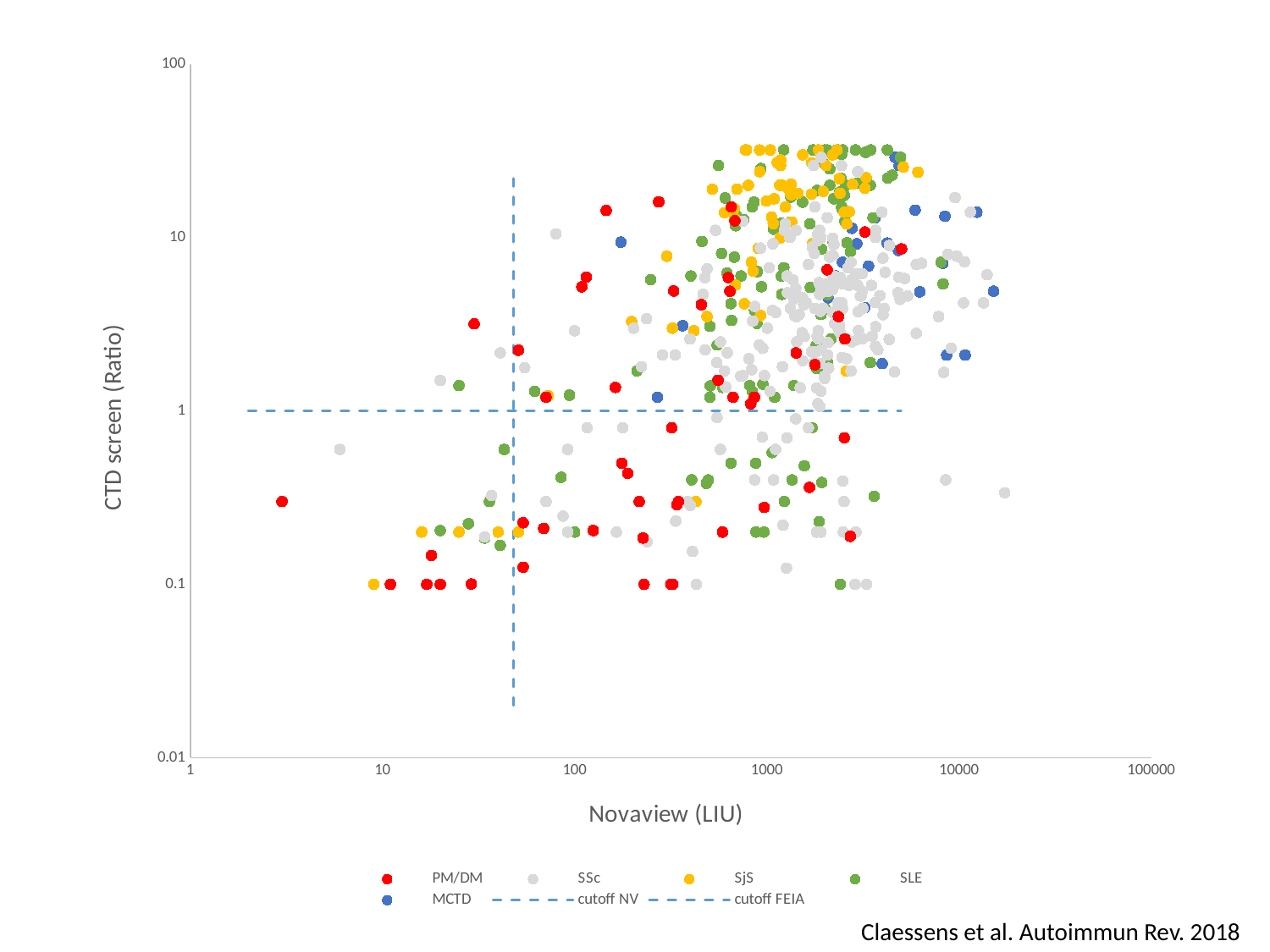
Are the SjS points mostly above or below the cutoff FEIA line? above At what CTD screen ratio is the horizontal cutoff FEIA line drawn? 1 How many entries does the chart legend list? 7 Is the Novaview value of the vertical cutoff NV line greater or less than 10? greater What is the lowest value shown on the y axis? 0.01 What is the label of the x axis? Novaview (LIU) How many disease groups are plotted as point series in the chart? 5 What is the highest value shown on the x axis? 100000 What is the label of the y axis? CTD screen (Ratio) Is the Novaview value of the vertical cutoff NV line greater or less than 100? less What kind of chart is shown on the slide? scatter chart What is the highest value shown on the y axis? 100